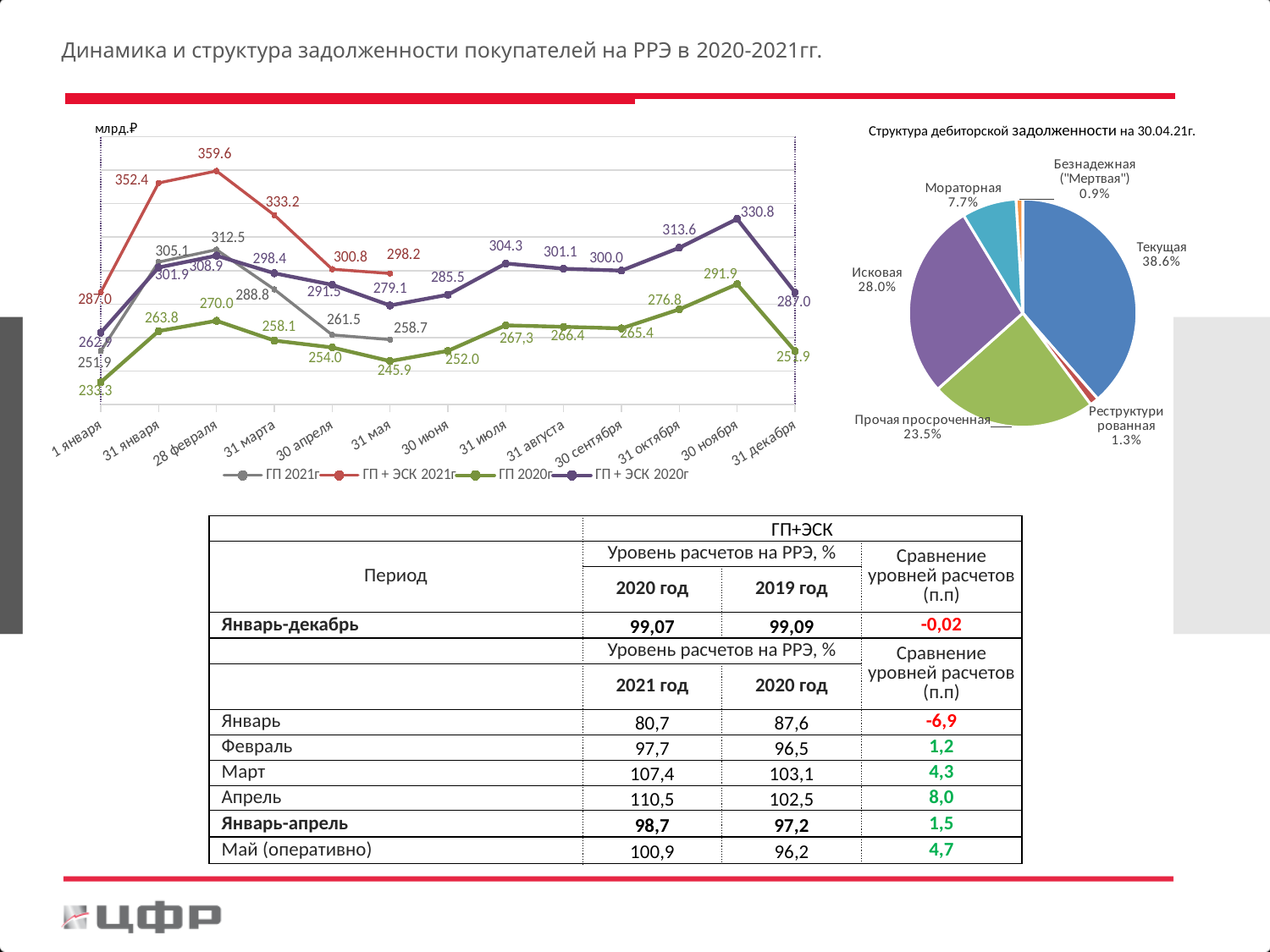
On the line chart, at which date does the ГП + ЭСК 2021г series reach its highest value? 28 февраля On the line chart, is the ГП 2020г value larger on 30 ноября or on 31 декабря? 30 ноября In the pie chart 'Структура дебиторской задолженности на 30.04.21г.', what share does Исковая have? 28.0% On the line chart, what is the difference between ГП + ЭСК 2021г (352.4) and ГП + ЭСК 2020г (301.9) on 31 января? 50.5 In the pie chart 'Структура дебиторской задолженности на 30.04.21г.', which category has the largest share? Текущая On the line chart, what is the value of the ГП + ЭСК 2021г series on 28 февраля? 359.6 On the line chart, at which date is the ГП 2020г series at its lowest? 1 января How many slices does the pie chart 'Структура дебиторской задолженности на 30.04.21г.' have? 6 On the line chart, what is the value of the ГП + ЭСК 2020г series on 30 ноября? 330.8 What kind of chart is the chart on the left of the slide? Line chart On the line chart, what is the value of the ГП 2020г series on 31 мая? 245.9 How many series does the legend of the line chart list? 4